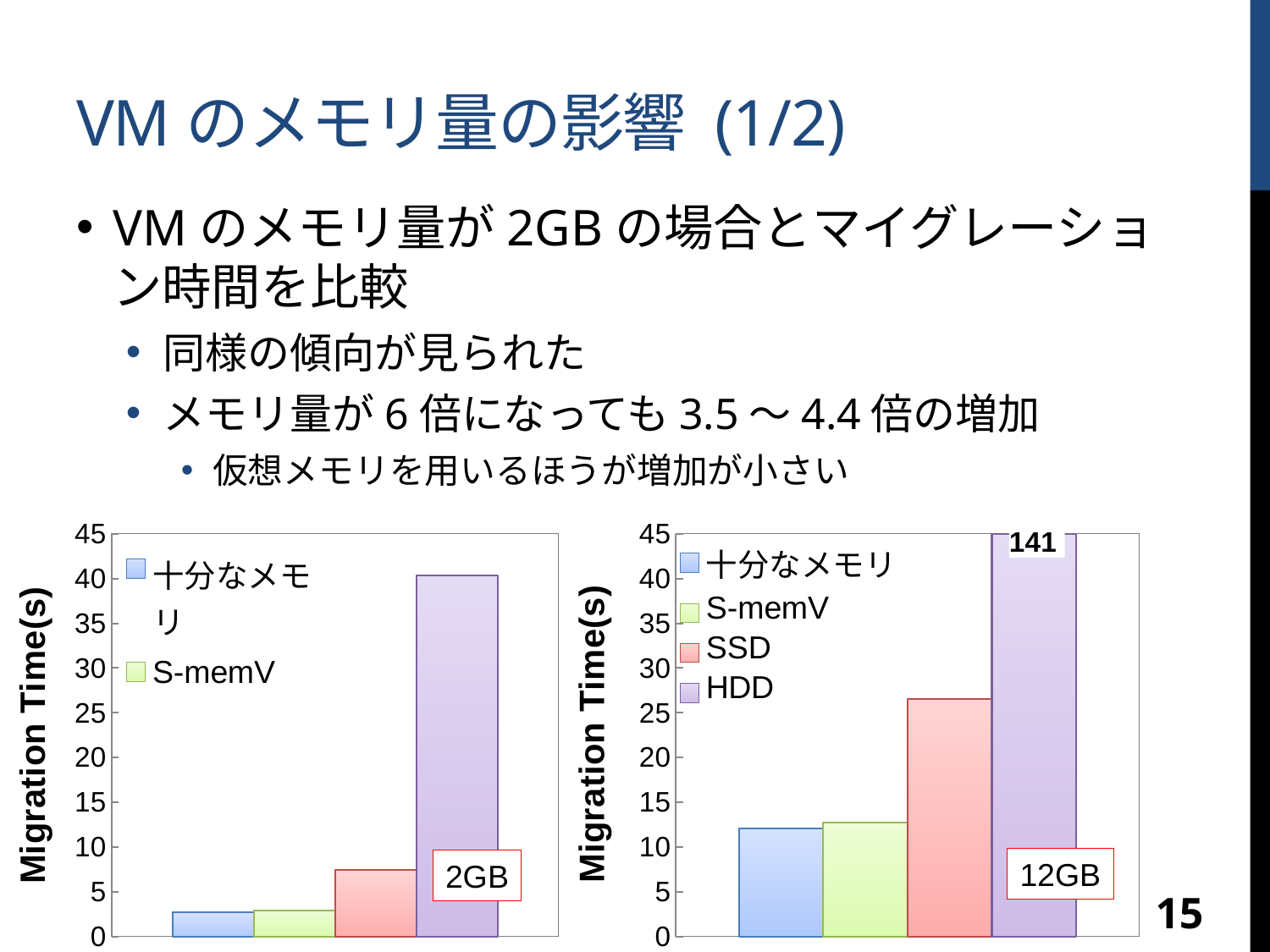
On the left chart (2GB), is the value of the red bar greater or less than 10? less On the right chart (12GB), which series has the lowest migration time? 十分なメモリ On the right chart (12GB), is the value for 十分なメモリ greater or less than 10? greater On the right chart (12GB), what is the migration time for HDD? 141 On the left chart (2GB), is the value of the purple bar greater or less than 35? greater What kind of chart is the left chart (2GB)? bar chart How many series does the legend of the right chart (12GB) list? 4 On the right chart (12GB), which series has the highest migration time? HDD What is the y-axis label of the left chart (2GB)? Migration Time(s) How many bars are plotted on the right chart (12GB)? 4 On the right chart (12GB), which is larger, the value for SSD or the value for S-memV? SSD